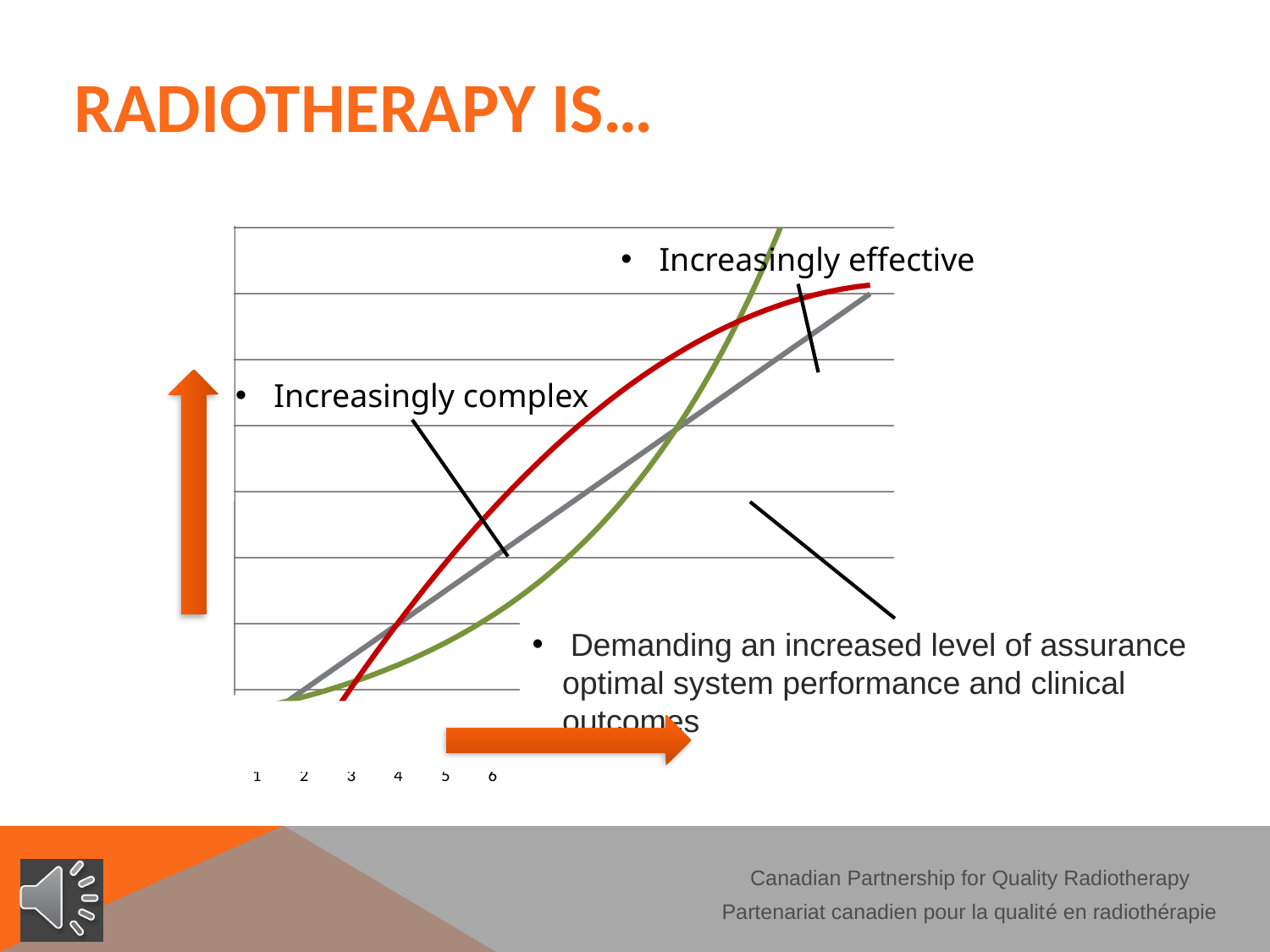
Which coloured line reaches the highest point at the right-hand end of the chart? green How many numbered tick labels are shown along the x axis of the chart? 6 What kind of chart is shown on the slide? line chart Does the green line rise or fall along the x axis? rise Does the red line rise or fall along the x axis? rise What colours are the three lines plotted on the chart? red, grey and green Do the plotted lines rise or fall as you move from left to right along the x axis? rise Which coloured line on the chart is straight rather than curved? grey How many lines are plotted on the chart? 3